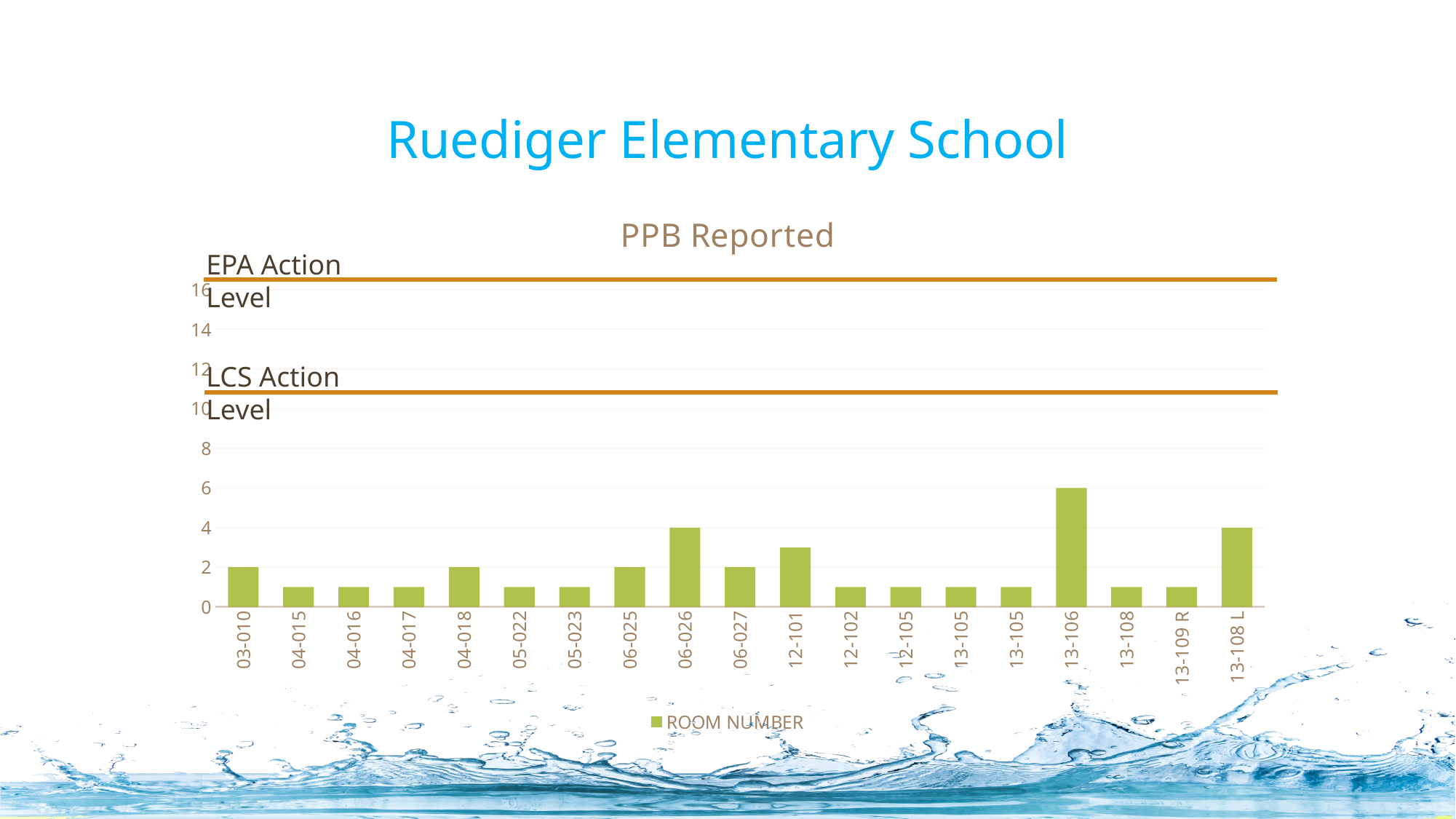
What type of chart is shown on the slide? bar chart How many series does the legend list? 1 What is the difference between the values for room 13-106 and room 06-026? 2 What is the title of the chart? PPB Reported What is the PPB reported value for room 13-106? 6 What is the PPB reported value for room 06-026? 4 How many room numbers are plotted on the x axis? 19 Is the value for room 12-101 greater or less than 2? greater Which has a larger value, room 13-106 or room 13-108 L? 13-106 Which room number has the highest PPB reported value? 13-106 What is the PPB reported value for room 03-010? 2 What is the PPB reported value for room 13-108 L? 4